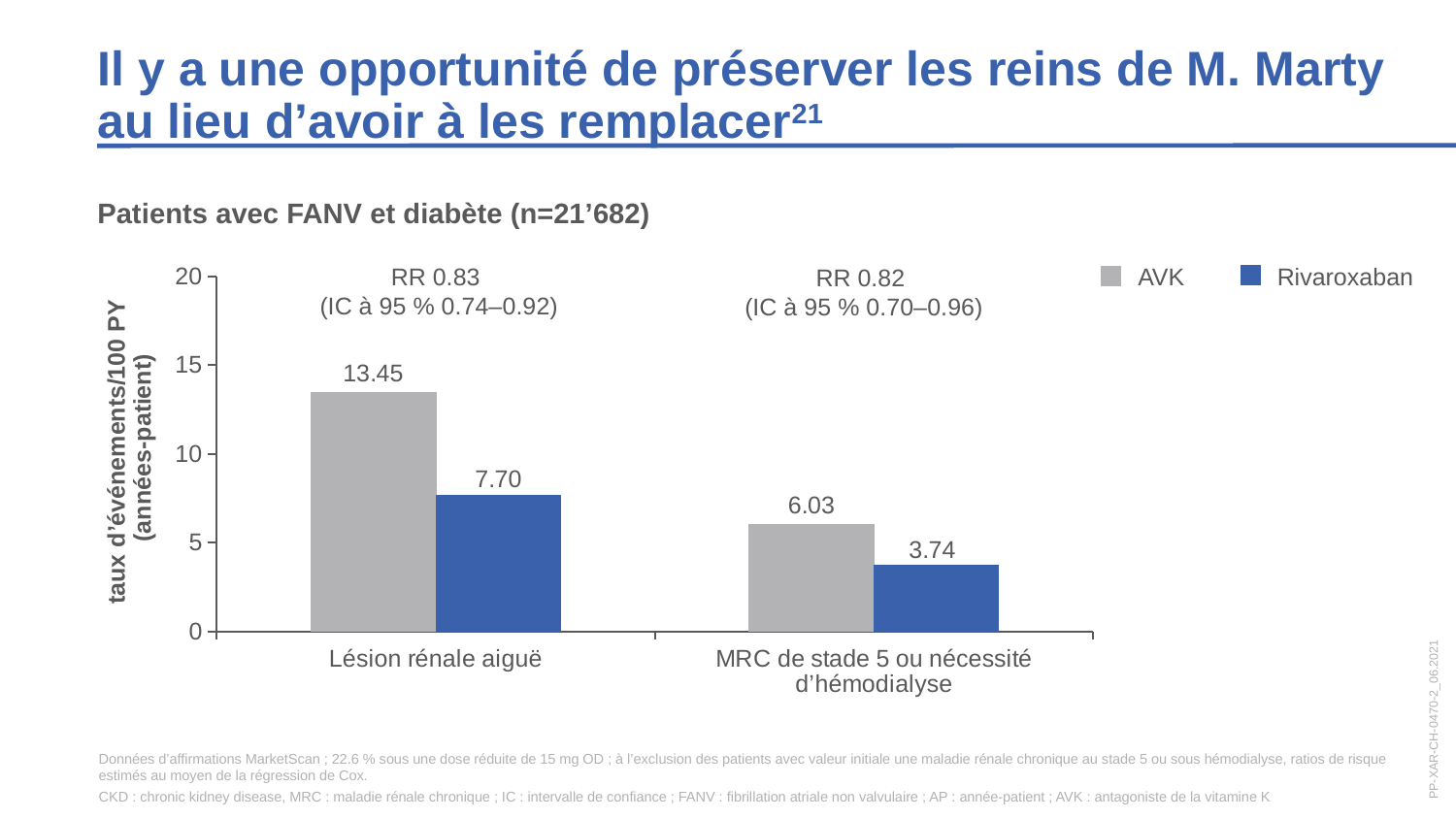
What is the event rate for AVK in the 'MRC de stade 5 ou nécessité d'hémodialyse' category? 6.03 What is the event rate for Rivaroxaban in the 'MRC de stade 5 ou nécessité d'hémodialyse' category? 3.74 Which bar has the highest value on the chart? AVK, Lésion rénale aiguë What is the event rate for AVK in the 'Lésion rénale aiguë' category? 13.45 Which bar has the lowest value on the chart? Rivaroxaban, MRC de stade 5 ou nécessité d'hémodialyse What is the event rate for Rivaroxaban in the 'Lésion rénale aiguë' category? 7.70 What is the difference between the AVK and Rivaroxaban values for 'MRC de stade 5 ou nécessité d'hémodialyse'? 2.29 What kind of chart is shown on the slide? Bar chart How many categories are shown on the x axis? 2 What is the difference between the AVK and Rivaroxaban values for 'Lésion rénale aiguë'? 5.75 Which is larger: the Rivaroxaban value for 'Lésion rénale aiguë' or the AVK value for 'MRC de stade 5 ou nécessité d'hémodialyse'? Rivaroxaban value for Lésion rénale aiguë How many series does the legend list? 2